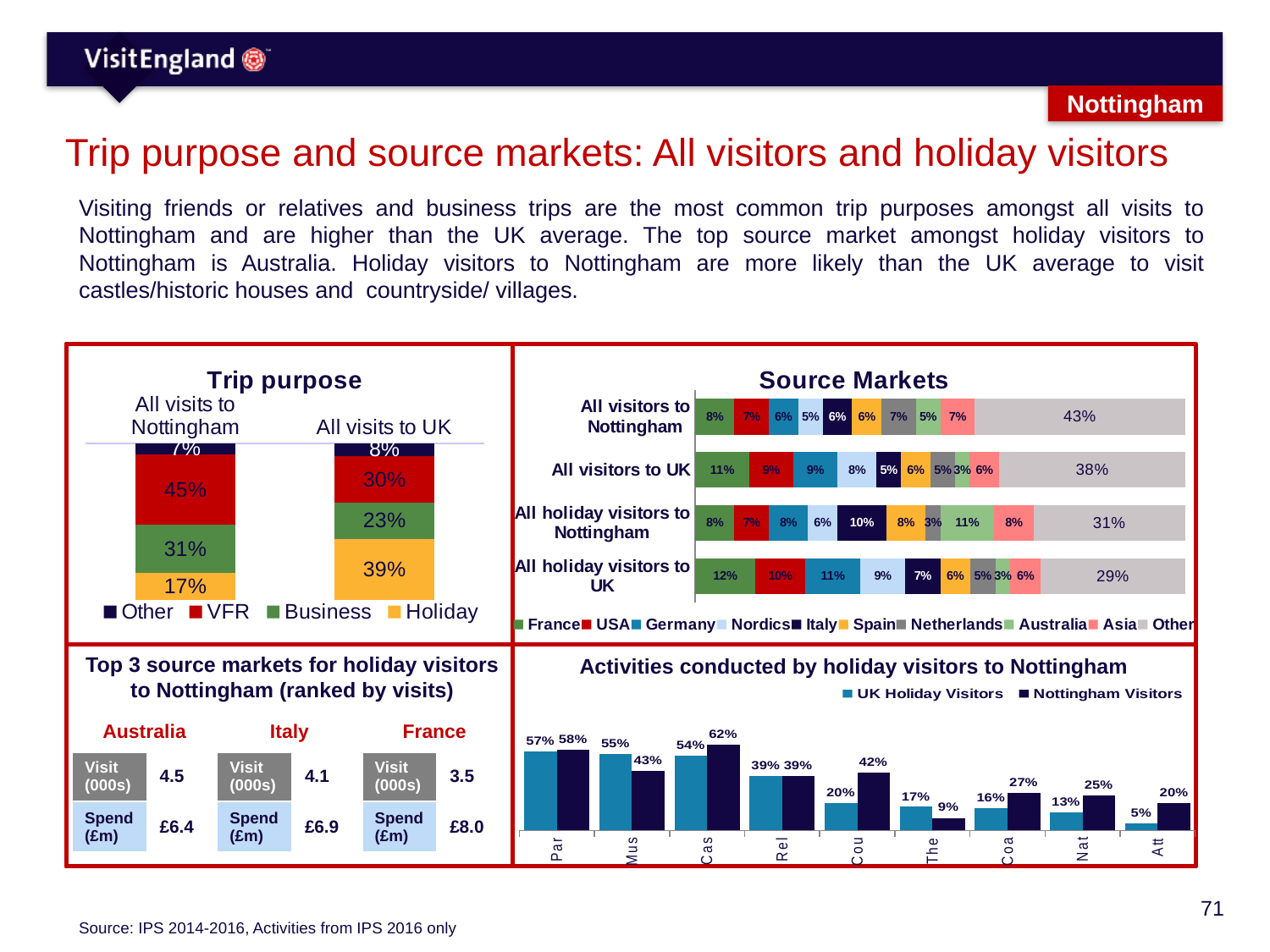
In the Trip purpose chart, what percentage of all visits to Nottingham are VFR? 45% In the Activities conducted by holiday visitors to Nottingham chart, which is larger for the category labelled Cou: UK Holiday Visitors or Nottingham Visitors? Nottingham Visitors In the Top 3 source markets for holiday visitors to Nottingham chart, what is the spend (£m) for France? £8.0 In the Activities conducted by holiday visitors to Nottingham chart, what is the value for Nottingham Visitors for the category labelled Cas? 62% In the Trip purpose chart, what percentage of all visits to UK are Holiday? 39% In the Trip purpose chart, how many series does the legend list? 4 In the Top 3 source markets for holiday visitors to Nottingham chart, which market has the highest number of visits (000s)? Australia In the Trip purpose chart, what is the difference between the Business share for all visits to Nottingham and for all visits to UK? 8 percentage points In the Source Markets chart, how many source market series does the legend list? 10 In the Source Markets chart, what is the Other share for all visitors to Nottingham? 43% In the Source Markets chart, what is the Australia share for all holiday visitors to Nottingham? 11% What kind of chart is the Activities conducted by holiday visitors to Nottingham chart? Bar chart